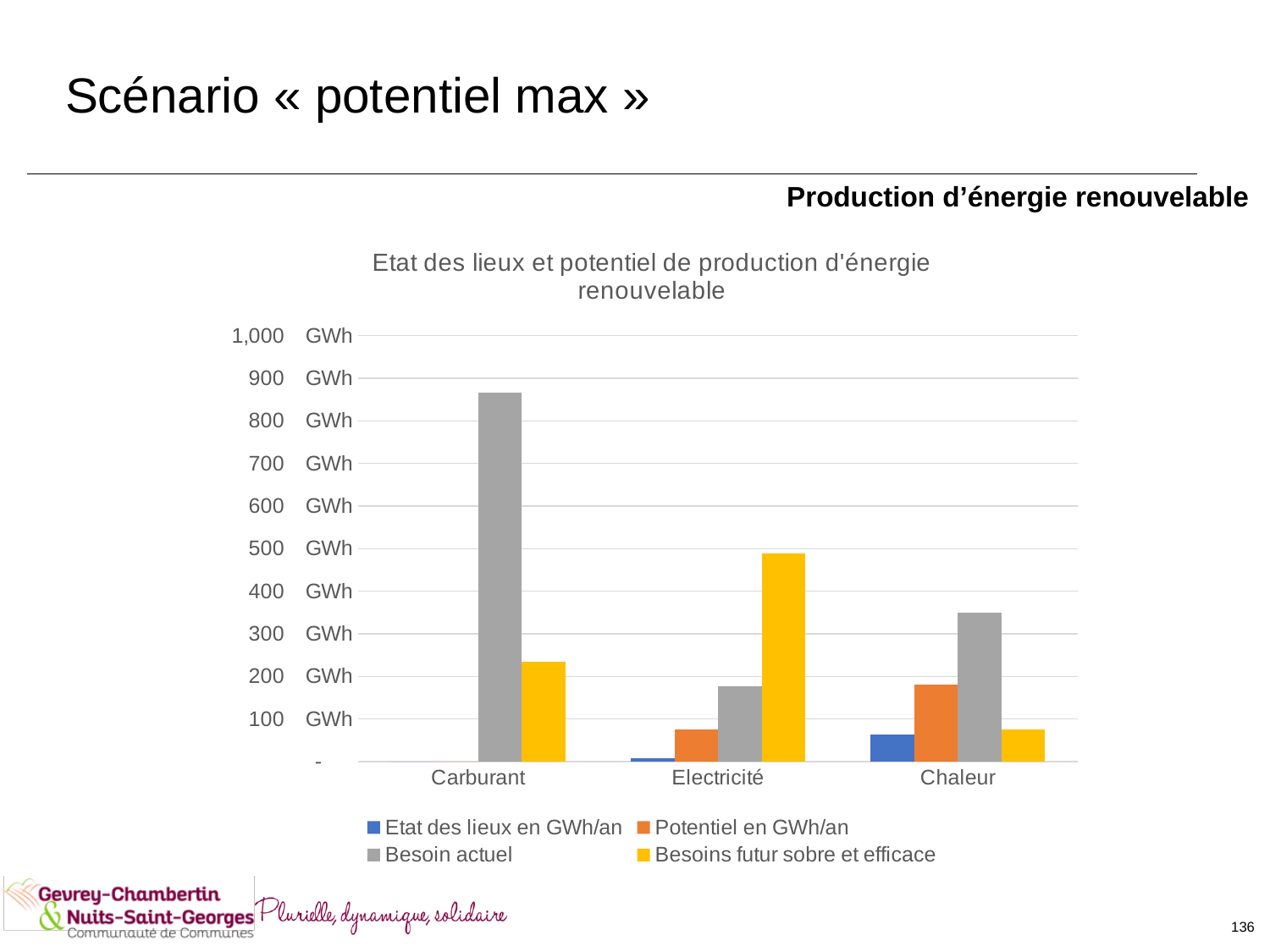
Is the 'Besoin actuel' value for Carburant greater or less than 800 GWh? greater Which category has the lowest 'Besoin actuel' value? Electricité Which category has the highest 'Besoins futur sobre et efficace' value? Electricité Which series is shown in yellow in the chart? Besoins futur sobre et efficace How many series does the chart's legend list? 4 Which is larger: the 'Besoins futur sobre et efficace' value for Electricité or for Chaleur? Electricité Is the 'Besoins futur sobre et efficace' value for Electricité greater or less than 400 GWh? greater What is the title of the chart? Etat des lieux et potentiel de production d'énergie renouvelable Is the 'Besoins futur sobre et efficace' value for Carburant greater or less than 300 GWh? less What kind of chart is shown on the slide? bar chart Which category has the highest 'Besoin actuel' value? Carburant How many categories are shown on the x axis of the chart? 3